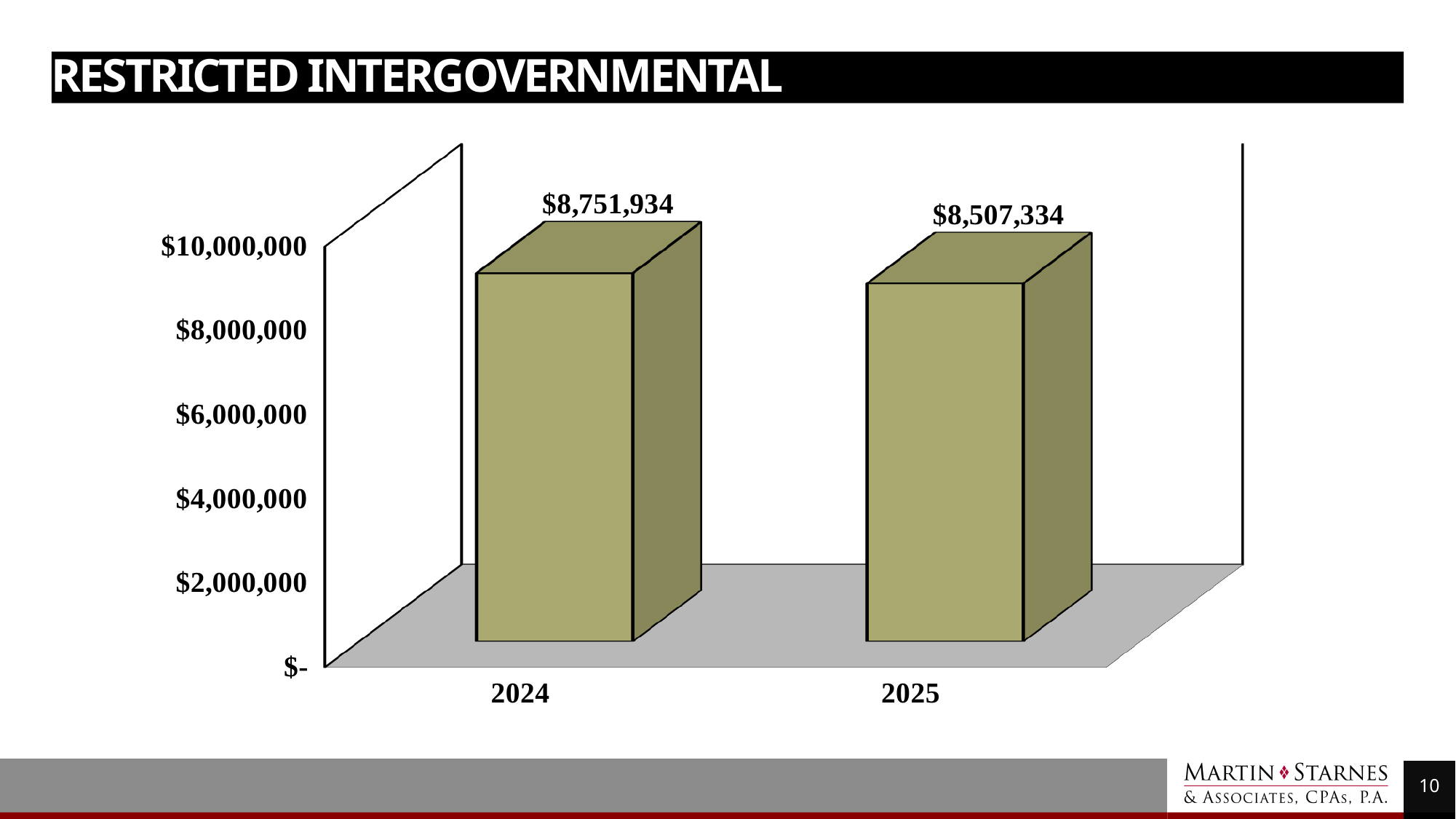
What is the value for 2024? $8,751,934 What is the value for 2025? $8,507,334 Which year has the lowest value? 2025 How many years are shown on the chart? 2 What is the difference between the 2024 and 2025 values? $244,600 What is the title of the slide? RESTRICTED INTERGOVERNMENTAL Is the value for 2024 greater or less than $10,000,000? less Do the values rise or fall from 2024 to 2025? fall Is the value for 2025 greater or less than $8,000,000? greater What kind of chart is shown on the slide? bar chart Which year has the highest value? 2024 Which is larger, the value for 2024 or the value for 2025? 2024